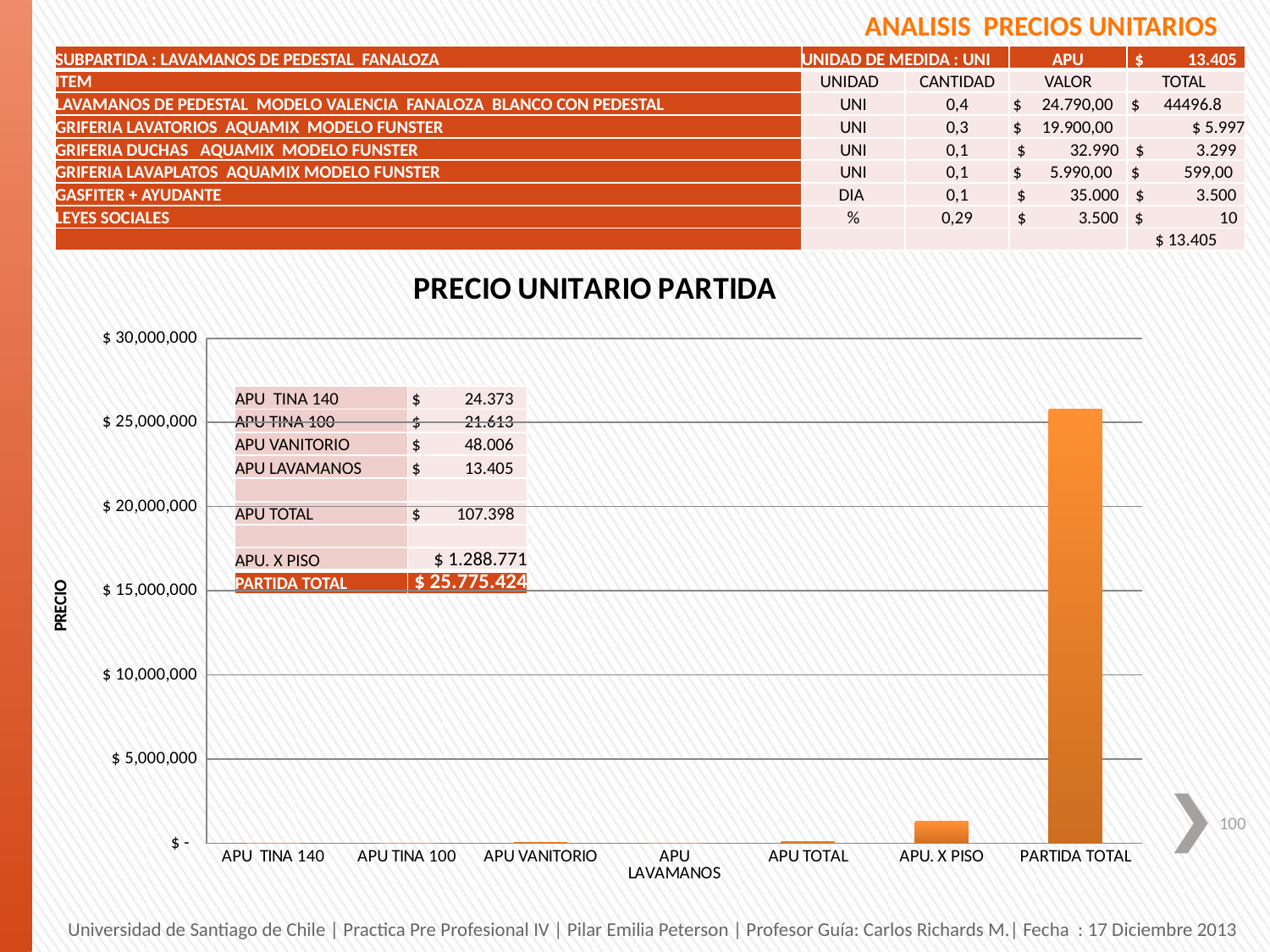
Which category has the highest bar in the PRECIO UNITARIO PARTIDA chart? PARTIDA TOTAL In the PRECIO UNITARIO PARTIDA chart, which is larger: APU. X PISO or APU TOTAL? APU. X PISO According to the table shown on the PRECIO UNITARIO PARTIDA chart, what is the value for APU VANITORIO? $ 48.006 According to the table shown on the PRECIO UNITARIO PARTIDA chart, what is the value for APU. X PISO? $ 1.288.771 What is the label of the vertical axis of the PRECIO UNITARIO PARTIDA chart? PRECIO In the PRECIO UNITARIO PARTIDA chart, is the value for PARTIDA TOTAL greater or less than $ 20,000,000? greater What is the title of the chart on the slide? PRECIO UNITARIO PARTIDA In the PRECIO UNITARIO PARTIDA chart, which is larger: PARTIDA TOTAL or APU. X PISO? PARTIDA TOTAL In the PRECIO UNITARIO PARTIDA chart, is the value for APU. X PISO greater or less than $ 5,000,000? less According to the table shown on the PRECIO UNITARIO PARTIDA chart, what is the value for PARTIDA TOTAL? $ 25.775.424 What type of chart is shown under the title PRECIO UNITARIO PARTIDA? bar chart How many categories are shown on the x axis of the PRECIO UNITARIO PARTIDA chart? 7